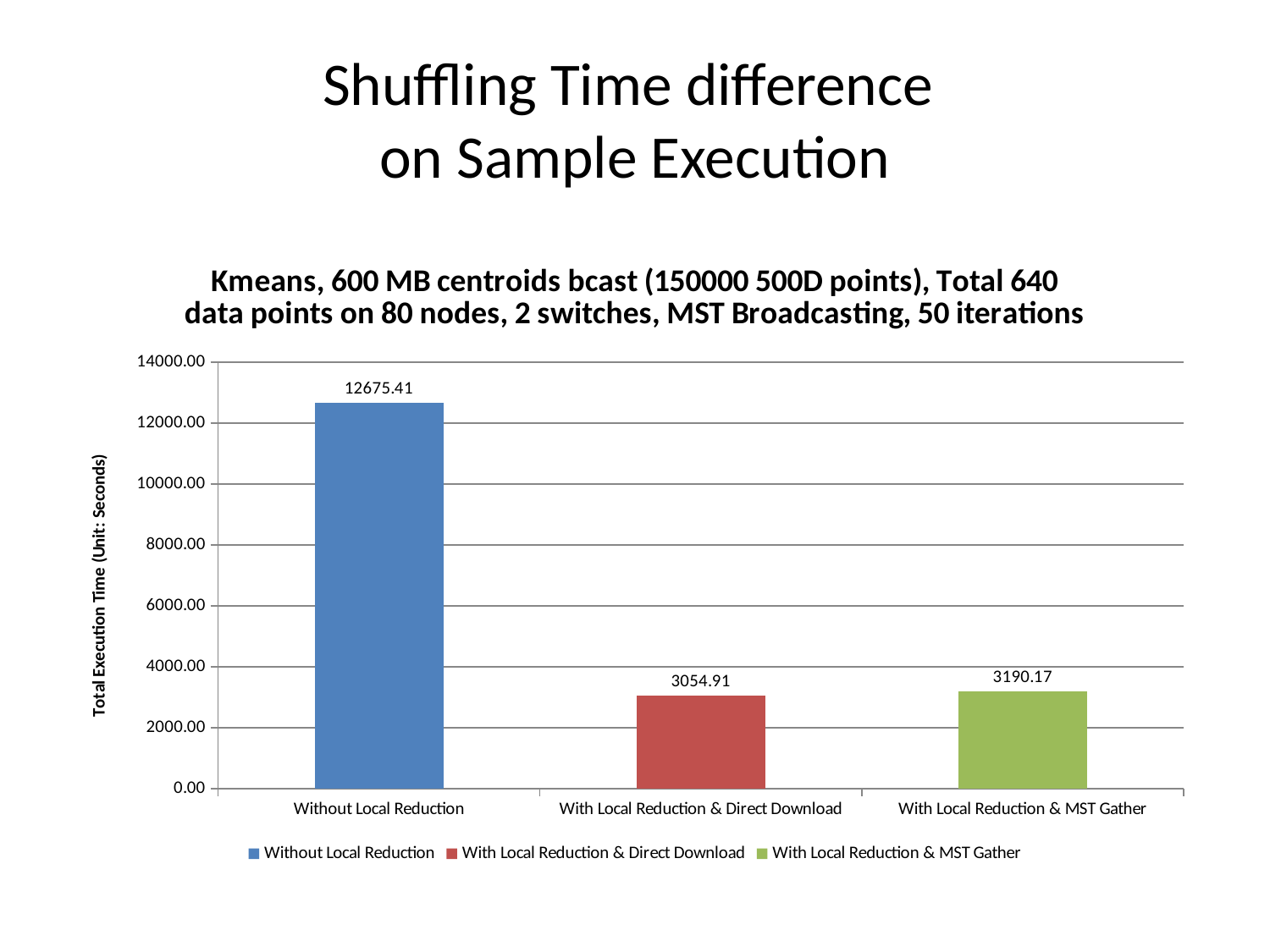
What is the difference in total execution time between With Local Reduction & MST Gather and With Local Reduction & Direct Download? 135.26 How many entries does the legend list? 3 What is the total execution time for With Local Reduction & MST Gather? 3190.17 Is the value for Without Local Reduction greater or less than 12000.00? greater What is the difference in total execution time between Without Local Reduction and With Local Reduction & Direct Download? 9620.50 What is the total execution time for Without Local Reduction? 12675.41 What is the total execution time for With Local Reduction & Direct Download? 3054.91 Which category has the lowest total execution time? With Local Reduction & Direct Download Which has a larger total execution time, With Local Reduction & Direct Download or With Local Reduction & MST Gather? With Local Reduction & MST Gather Which category has the highest total execution time? Without Local Reduction What kind of chart is shown on the slide? bar chart How many categories are shown on the x axis? 3